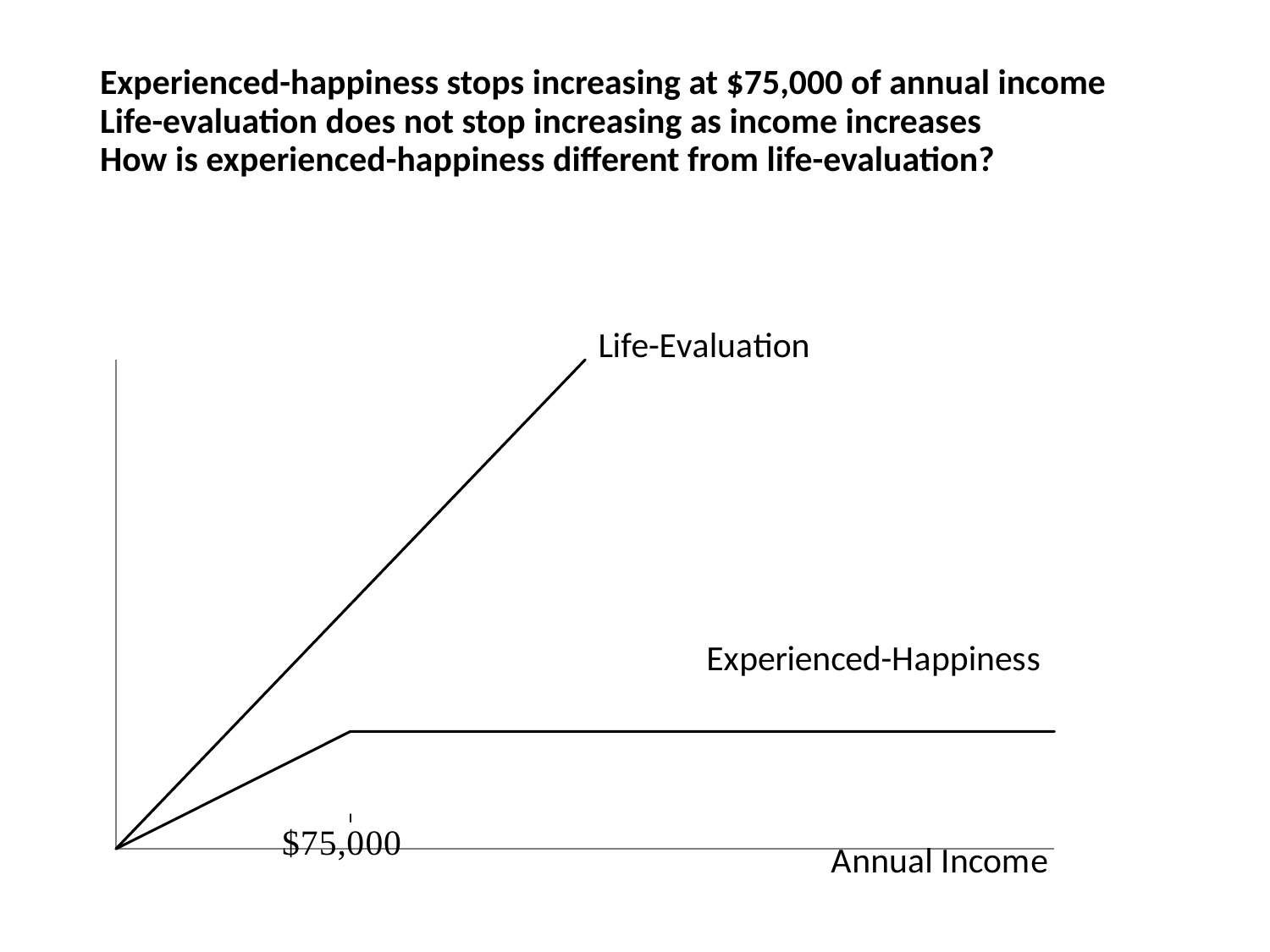
What happens to the Experienced-Happiness line after $75,000 of annual income? it stays flat At the right-hand end of the chart, which line is higher: Life-Evaluation or Experienced-Happiness? Life-Evaluation Does the Experienced-Happiness line rise or fall between zero and $75,000 of annual income? rise What is the label on the horizontal axis of the chart? Annual Income How many lines are plotted on the chart? 2 Which line ends at the lowest level on the chart? Experienced-Happiness What income value is marked on the horizontal axis of the chart? $75,000 Does the Life-Evaluation line rise or stay flat as annual income increases? rise At what annual income does the Experienced-Happiness line stop increasing? $75,000 Which line reaches the highest point on the chart? Life-Evaluation What kind of chart is shown on the slide? line chart